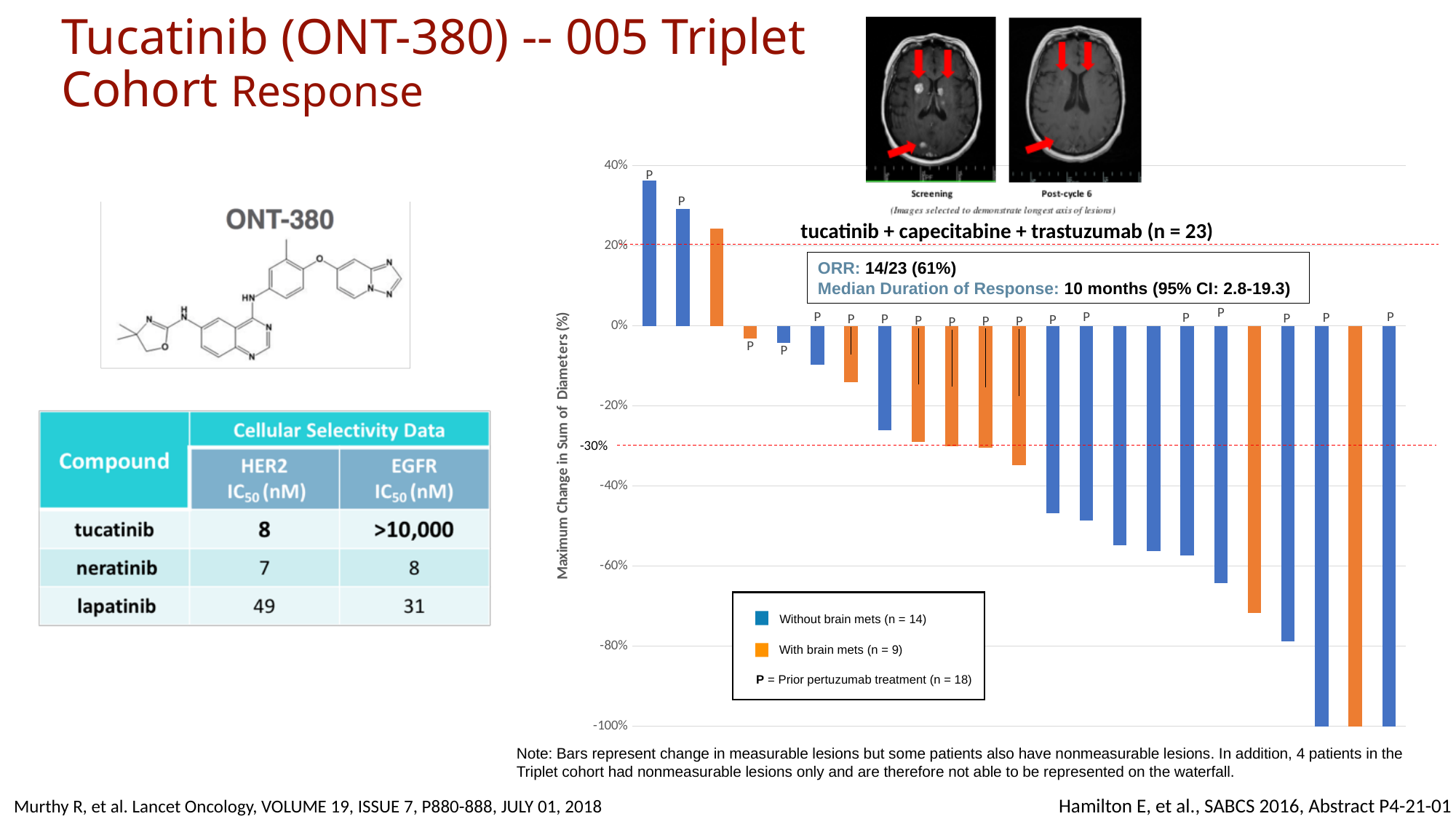
What is the value of the rightmost bar in the waterfall chart? -100% How many bars are plotted in the waterfall chart? 23 Is the value of the second bar from the left in the waterfall chart greater or less than 20%? greater What kind of chart is shown on the right side of the slide? bar chart Which is larger in the waterfall chart, the first bar or the second bar? the first bar Do the bar values in the waterfall chart rise or fall from left to right? fall In the waterfall chart, what does the orange colour represent? With brain mets (n = 9) Is the value of the first (leftmost) bar in the waterfall chart greater or less than 20%? greater How many coloured series does the legend of the waterfall chart list? 2 How many orange (with brain mets) bars are in the waterfall chart? 9 Which series does the tallest positive bar in the waterfall chart belong to? Without brain mets In the waterfall chart, what does the letter P above a bar indicate? Prior pertuzumab treatment